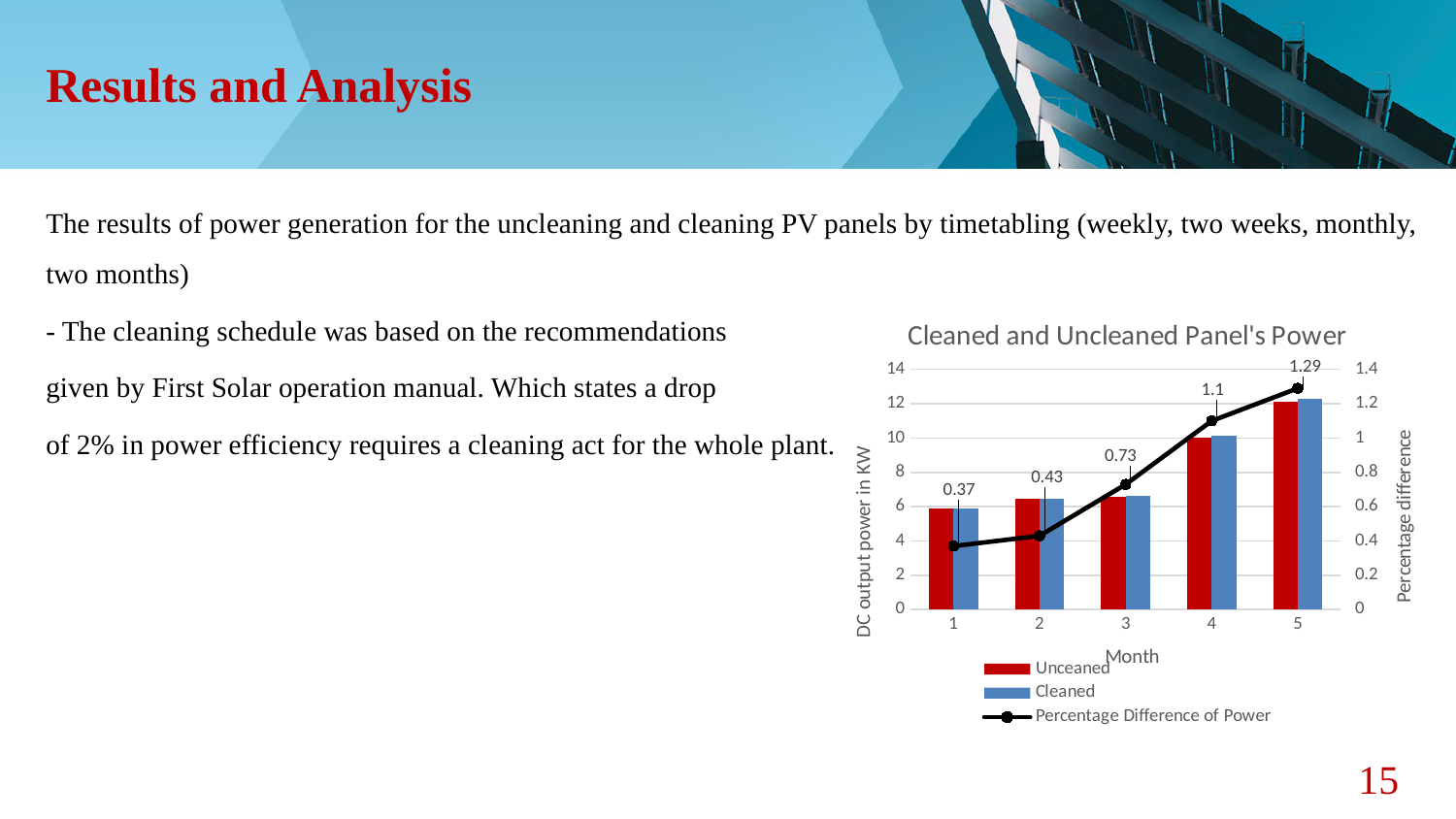
How many series does the legend list? 3 What is the Percentage Difference of Power value for month 5? 1.29 What is the title of the chart? Cleaned and Uncleaned Panel's Power What is the Percentage Difference of Power value for month 3? 0.73 Does the Percentage Difference of Power rise or fall from month 1 to month 5? rises Which month has the lowest Percentage Difference of Power? 1 Is the Cleaned DC output power for month 1 greater or less than 8? less What is the difference between the Percentage Difference of Power in month 5 and month 1? 0.92 How many months are shown on the x axis? 5 Is the Unceaned DC output power for month 5 greater or less than 10? greater What is the Percentage Difference of Power value for month 1? 0.37 Which month has the highest Percentage Difference of Power? 5